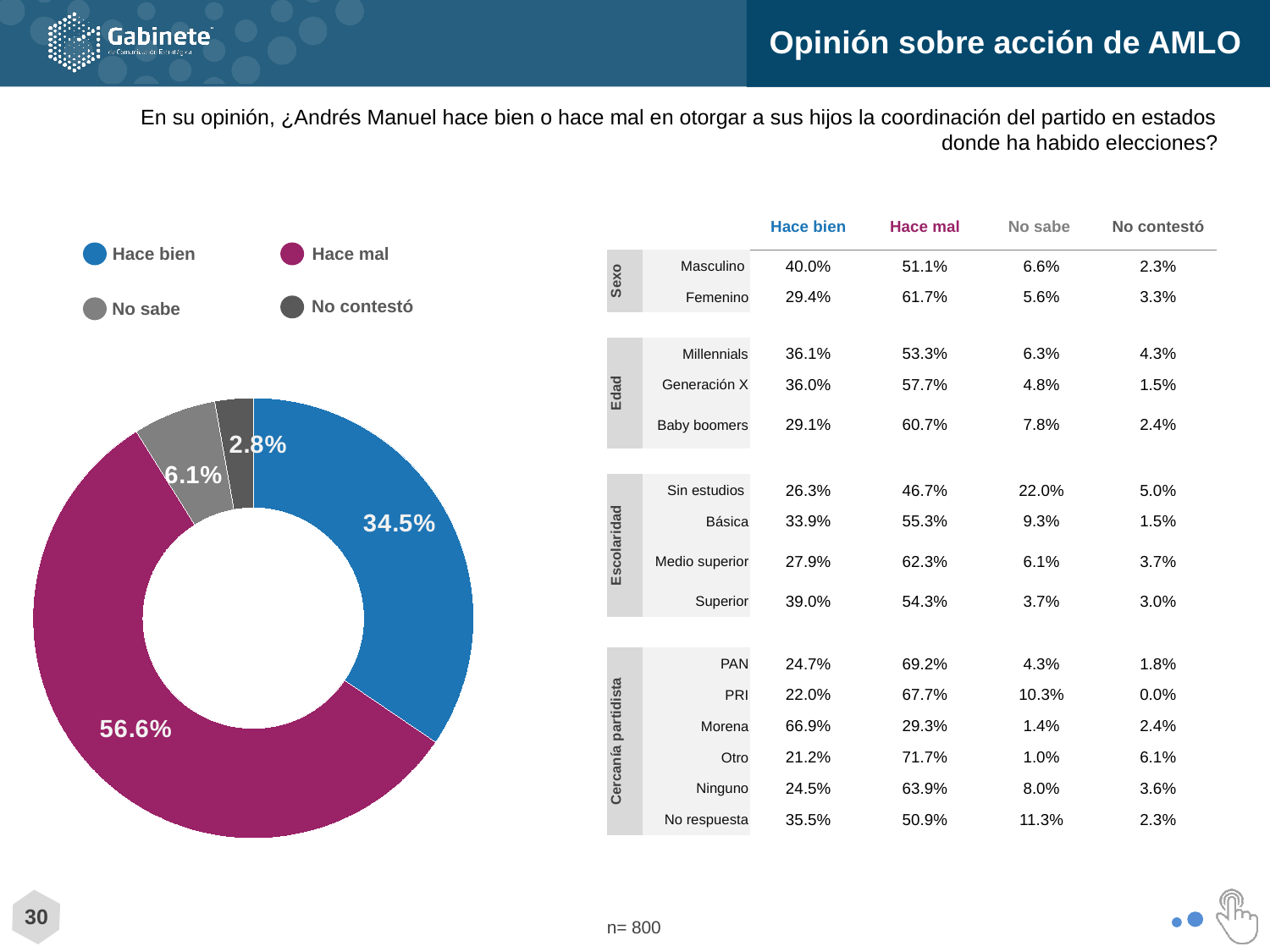
What is the difference in percentage points between "Hace mal" and "Hace bien" in the donut chart? 22.1 What percentage of respondents answered "Hace bien" in the donut chart? 34.5% Which is larger in the donut chart, "No sabe" or "No contestó"? No sabe What share of the donut chart corresponds to "No sabe"? 6.1% What percentage of respondents answered "Hace mal" in the donut chart? 56.6% What type of chart is shown on the left of the slide? Donut (pie) chart Which response has the smallest slice in the donut chart? No contestó Which colour represents "Hace bien" in the donut chart? Blue How many slices does the donut chart have? 4 Which response has the largest slice in the donut chart? Hace mal What share of the donut chart corresponds to "No contestó"? 2.8% How many entries does the legend of the donut chart list? 4